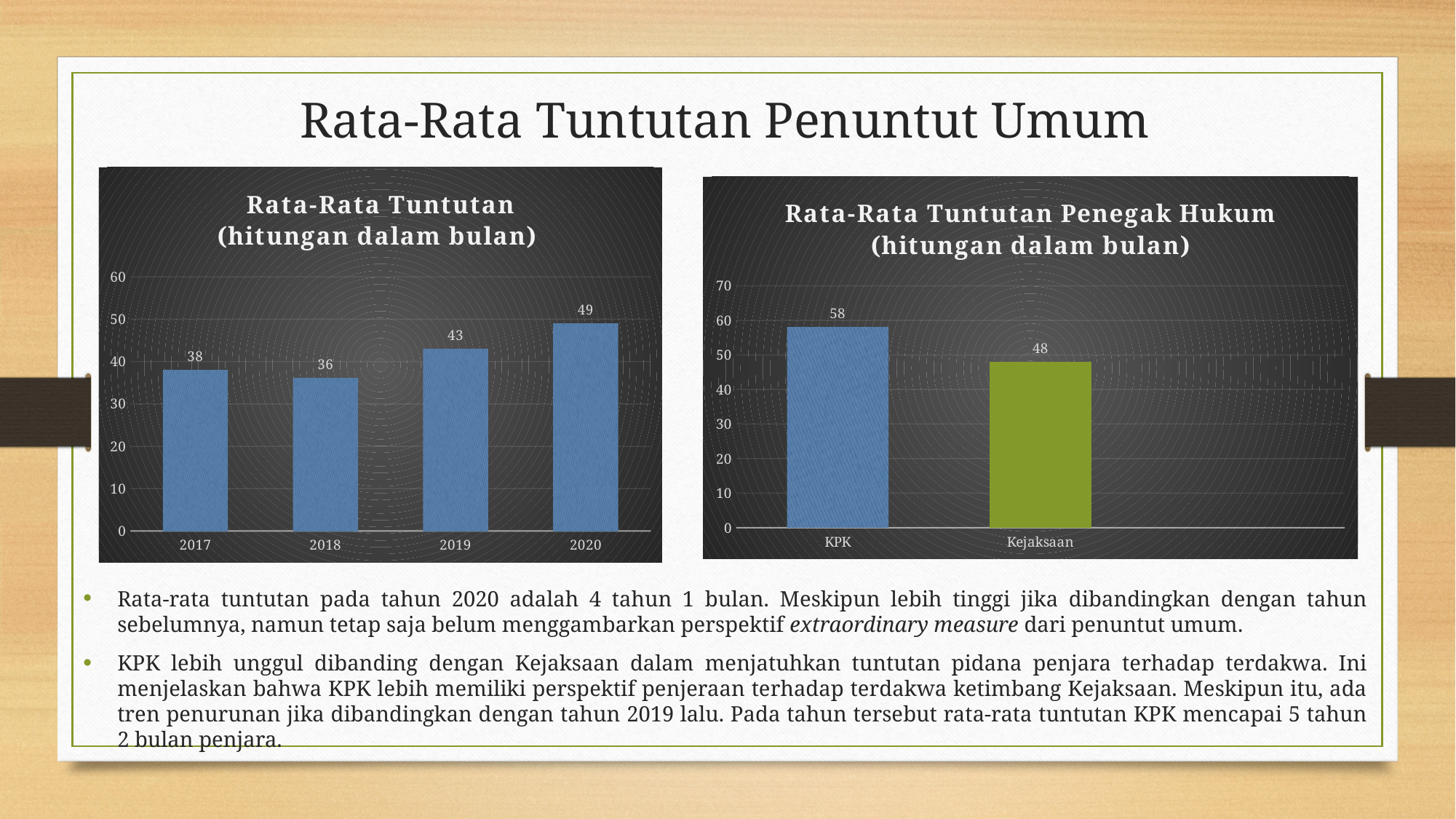
In the left chart 'Rata-Rata Tuntutan (hitungan dalam bulan)', which year has the highest value? 2020 In the left chart 'Rata-Rata Tuntutan (hitungan dalam bulan)', which year has the lowest value? 2018 In the right chart 'Rata-Rata Tuntutan Penegak Hukum (hitungan dalam bulan)', which is larger, KPK or Kejaksaan? KPK In the left chart 'Rata-Rata Tuntutan (hitungan dalam bulan)', what is the value for 2017? 38 In the left chart 'Rata-Rata Tuntutan (hitungan dalam bulan)', how many years are shown on the x axis? 4 In the left chart 'Rata-Rata Tuntutan (hitungan dalam bulan)', what is the value for 2020? 49 In the right chart 'Rata-Rata Tuntutan Penegak Hukum (hitungan dalam bulan)', what is the difference between KPK and Kejaksaan? 10 In the left chart 'Rata-Rata Tuntutan (hitungan dalam bulan)', do the values rise or fall from 2018 to 2020? rise In the right chart 'Rata-Rata Tuntutan Penegak Hukum (hitungan dalam bulan)', what is the value for KPK? 58 In the right chart 'Rata-Rata Tuntutan Penegak Hukum (hitungan dalam bulan)', what is the value for Kejaksaan? 48 What kind of chart is the right chart 'Rata-Rata Tuntutan Penegak Hukum (hitungan dalam bulan)'? bar chart In the left chart 'Rata-Rata Tuntutan (hitungan dalam bulan)', what is the difference between the values for 2020 and 2019? 6